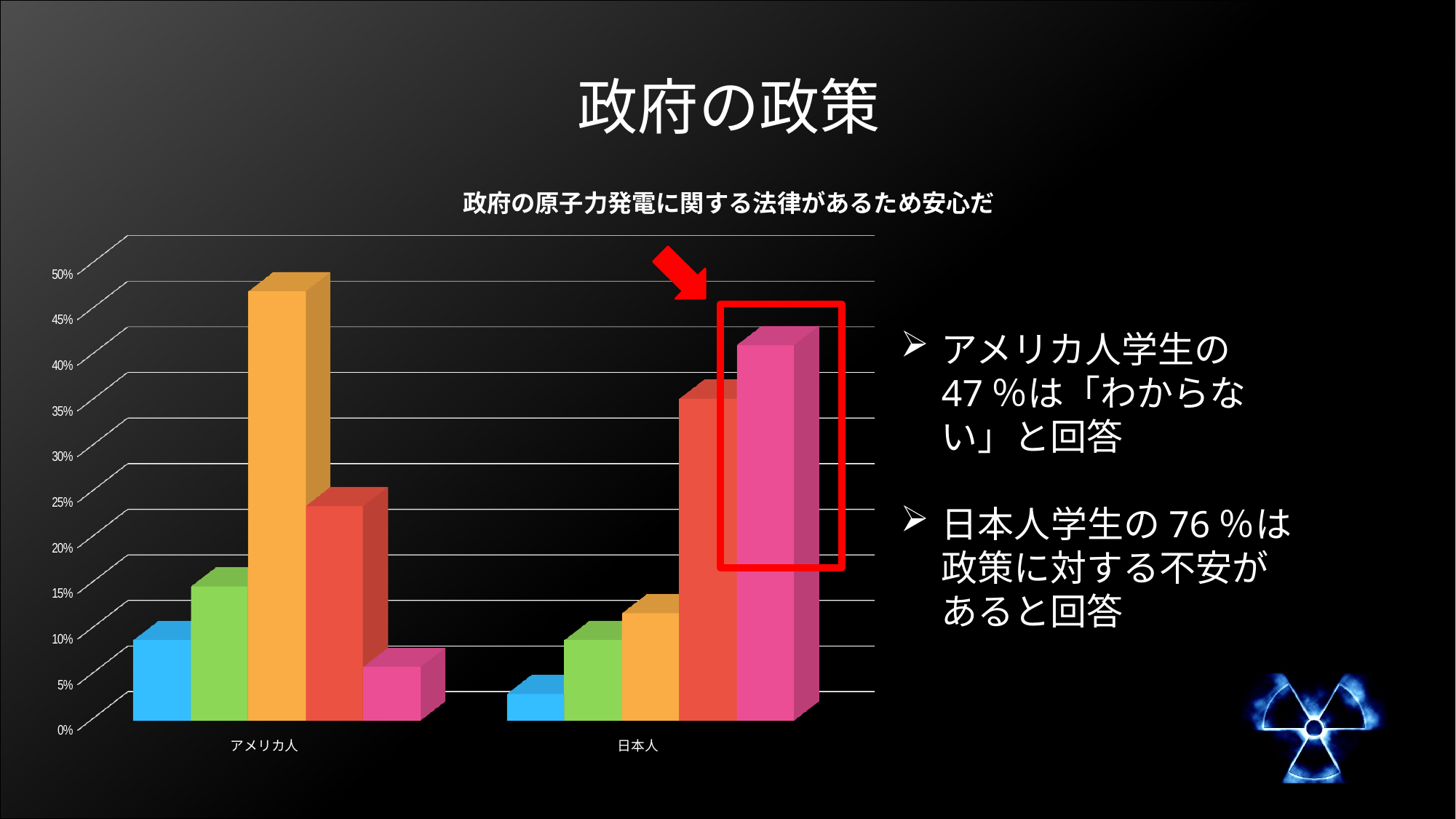
How many bars are plotted for each category in the chart? 5 Which bar is the shortest in the 日本人 group? the blue bar Is the value of the orange bar for アメリカ人 greater or less than 40%? greater How many categories are shown on the x axis of the chart? 2 Is the value of the pink bar for 日本人 greater or less than 35%? greater Which bar is the tallest in the 日本人 group? the pink bar Which is larger, the pink bar for アメリカ人 or the pink bar for 日本人? 日本人 What kind of chart is shown on the slide? bar chart Which bar is the tallest in the アメリカ人 group? the orange bar Which is larger, the orange bar for アメリカ人 or the orange bar for 日本人? アメリカ人 What is the title of the chart? 政府の原子力発電に関する法律があるため安心だ Is the value of the red bar for アメリカ人 greater or less than 30%? less